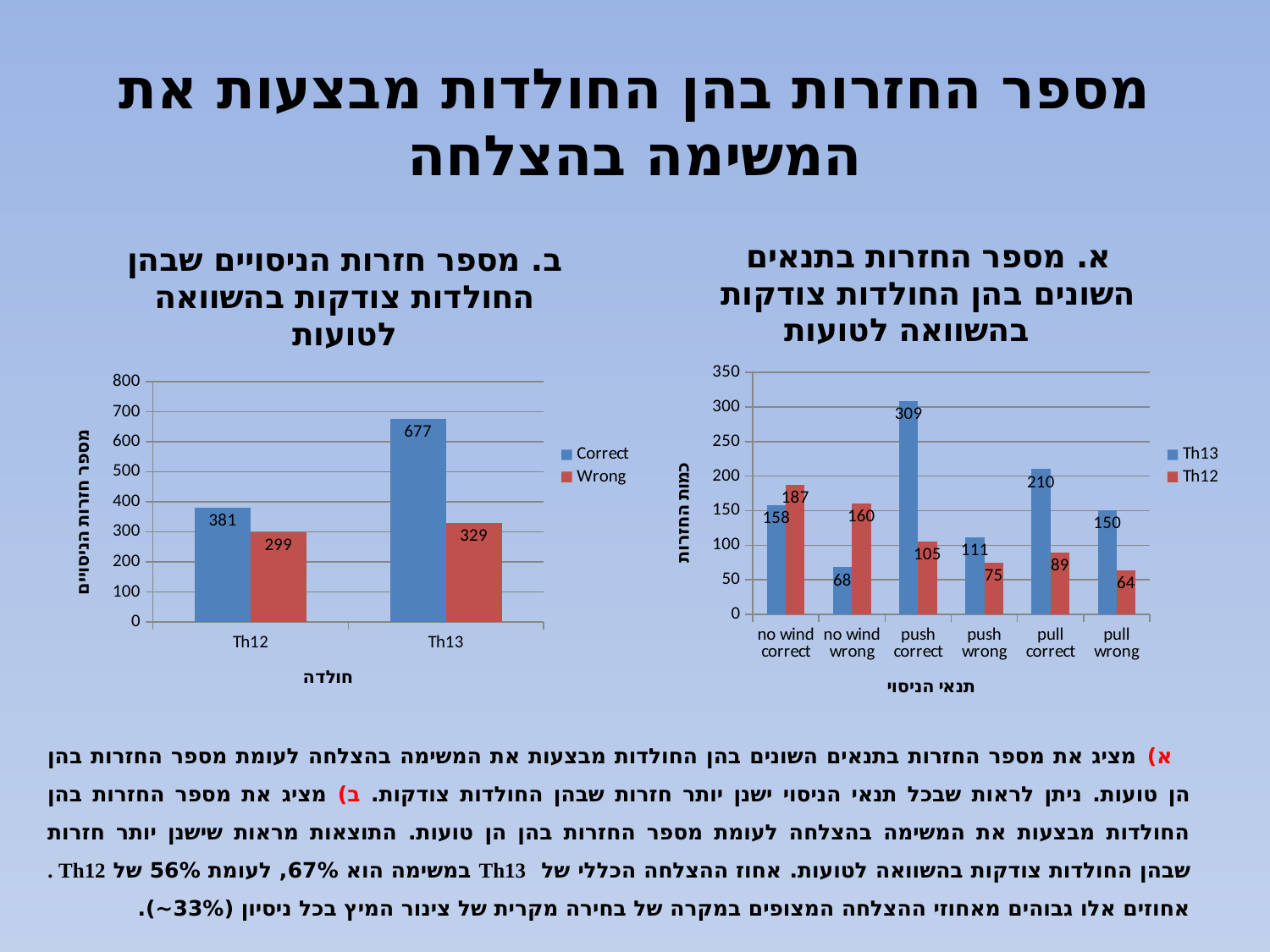
In the left chart, what is the Correct value for Th13? 677 In the left chart, which is larger for Th12: Correct or Wrong? Correct In the right chart, which category has the highest Th13 value? push correct In the right chart, which category has the lowest Th12 value? pull wrong What type of chart is the right chart? Bar chart In the right chart, what is the difference between the Th13 and Th12 values for no wind wrong? 92 In the right chart, what is the Th13 value for push correct? 309 In the left chart, what is the Wrong value for Th12? 299 In the left chart, what is the difference between the Correct and Wrong values for Th13? 348 In the right chart, what is the Th12 value for pull wrong? 64 In the right chart, how many categories are shown on the x axis? 6 In the left chart, how many series does the legend list? 2